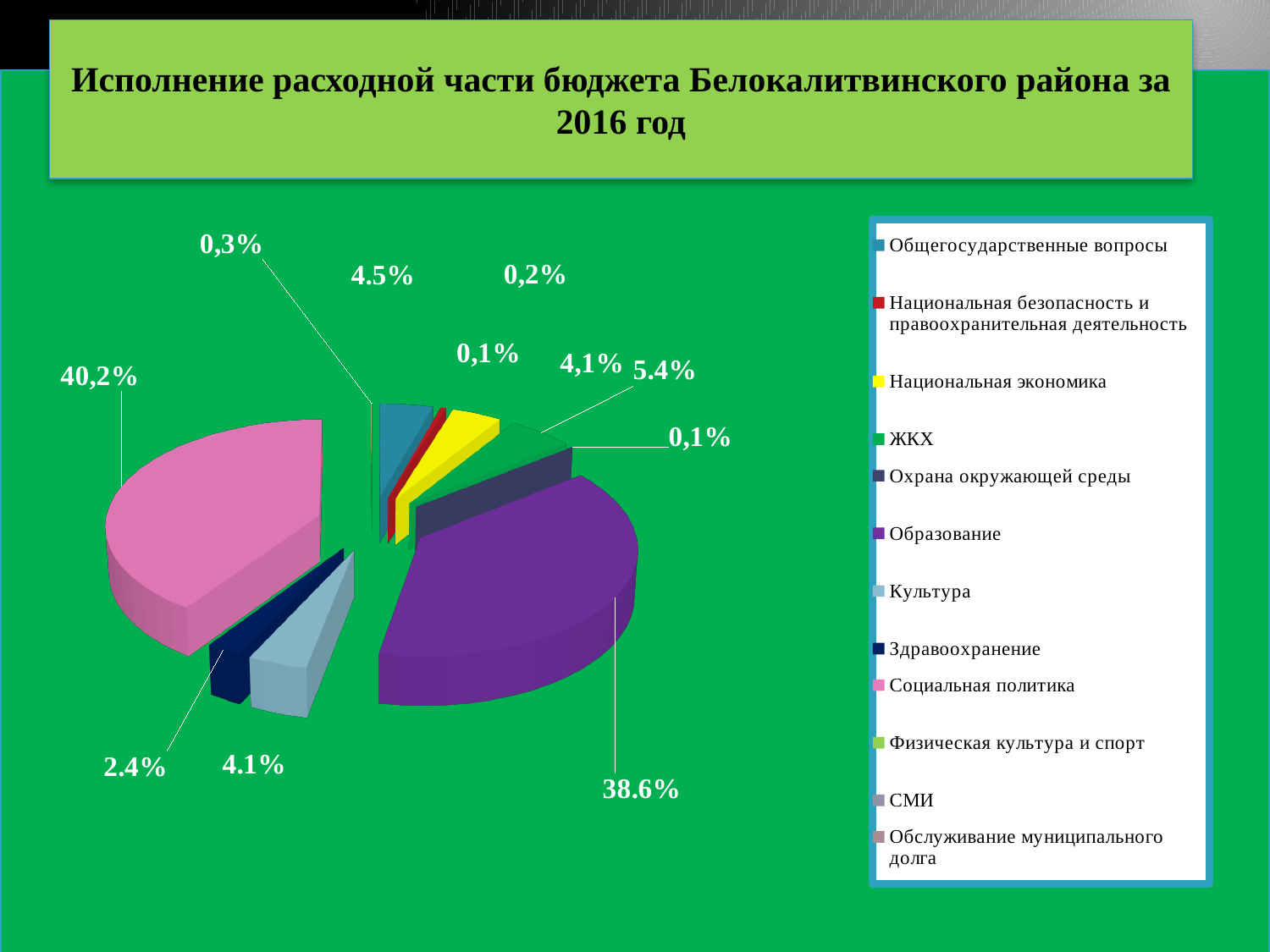
What is the title of the chart on the slide? Исполнение расходной части бюджета Белокалитвинского района за 2016 год Which category has the largest share of the pie? Социальная политика Which legend entry is shown in pink on the pie chart? Социальная политика What share of the pie does Охрана окружающей среды have? 0,1% What share of the pie does ЖКХ have? 5.4% Which is larger, the share for Социальная политика or the share for Образование? Социальная политика What kind of chart is shown on the slide? pie chart What share of the pie does Здравоохранение have? 2.4% By how many percentage points does the share for Образование exceed the share for ЖКХ? 33.2% How many entries does the legend of the pie chart list? 12